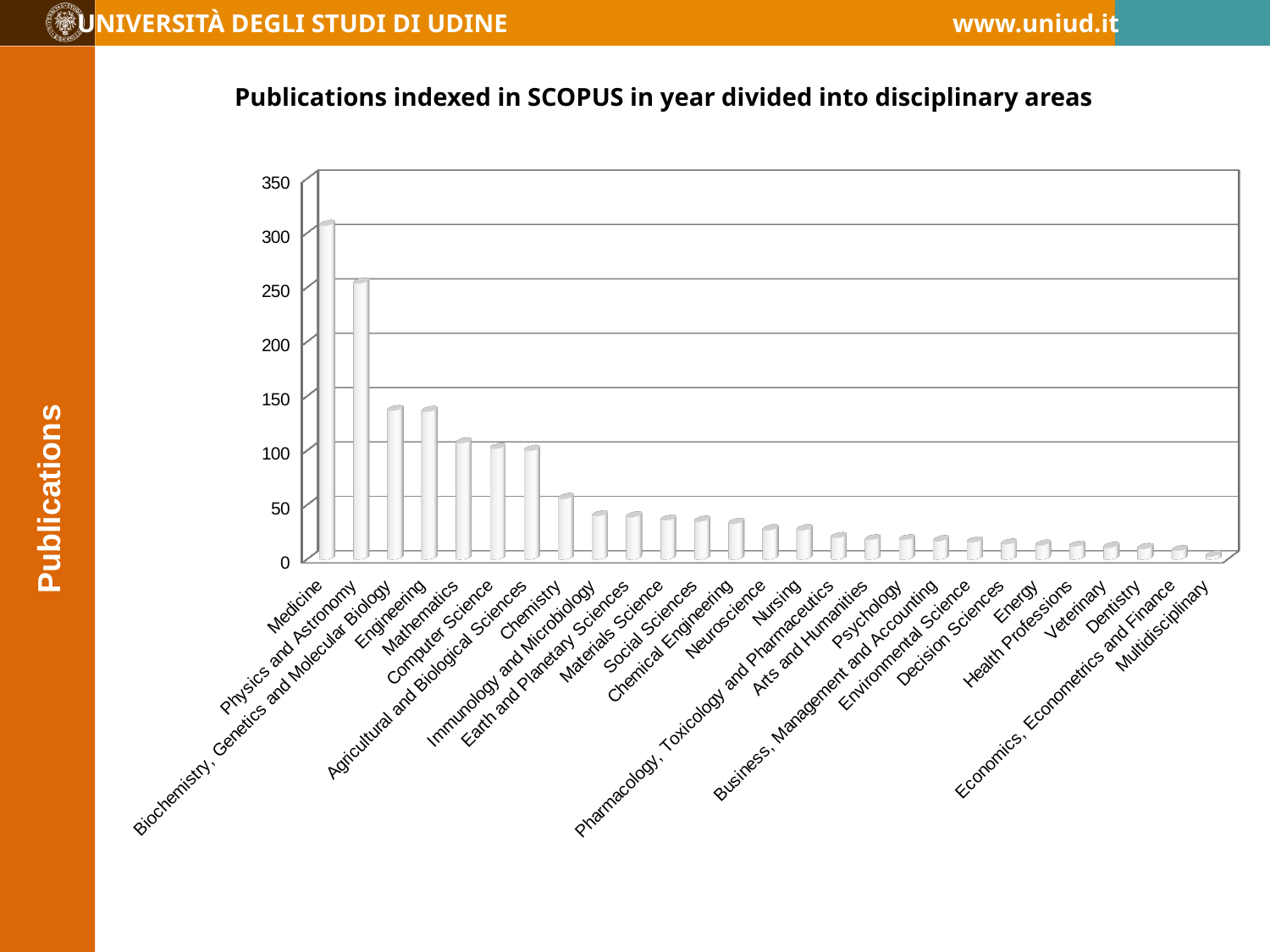
Do the values rise or fall moving from left to right along the x axis? fall Which has more publications, Mathematics or Chemistry? Mathematics Is the value for Medicine greater or less than 250? greater Which has more publications, Medicine or Physics and Astronomy? Medicine Is the value for Immunology and Microbiology greater or less than 50? less Which disciplinary area has the lowest number of publications? Multidisciplinary What kind of chart is shown on the slide? bar chart What is the title of the chart? Publications indexed in SCOPUS in year divided into disciplinary areas Is the value for Engineering greater or less than 100? greater Which disciplinary area has the highest number of publications? Medicine How many disciplinary areas are shown on the x axis? 27